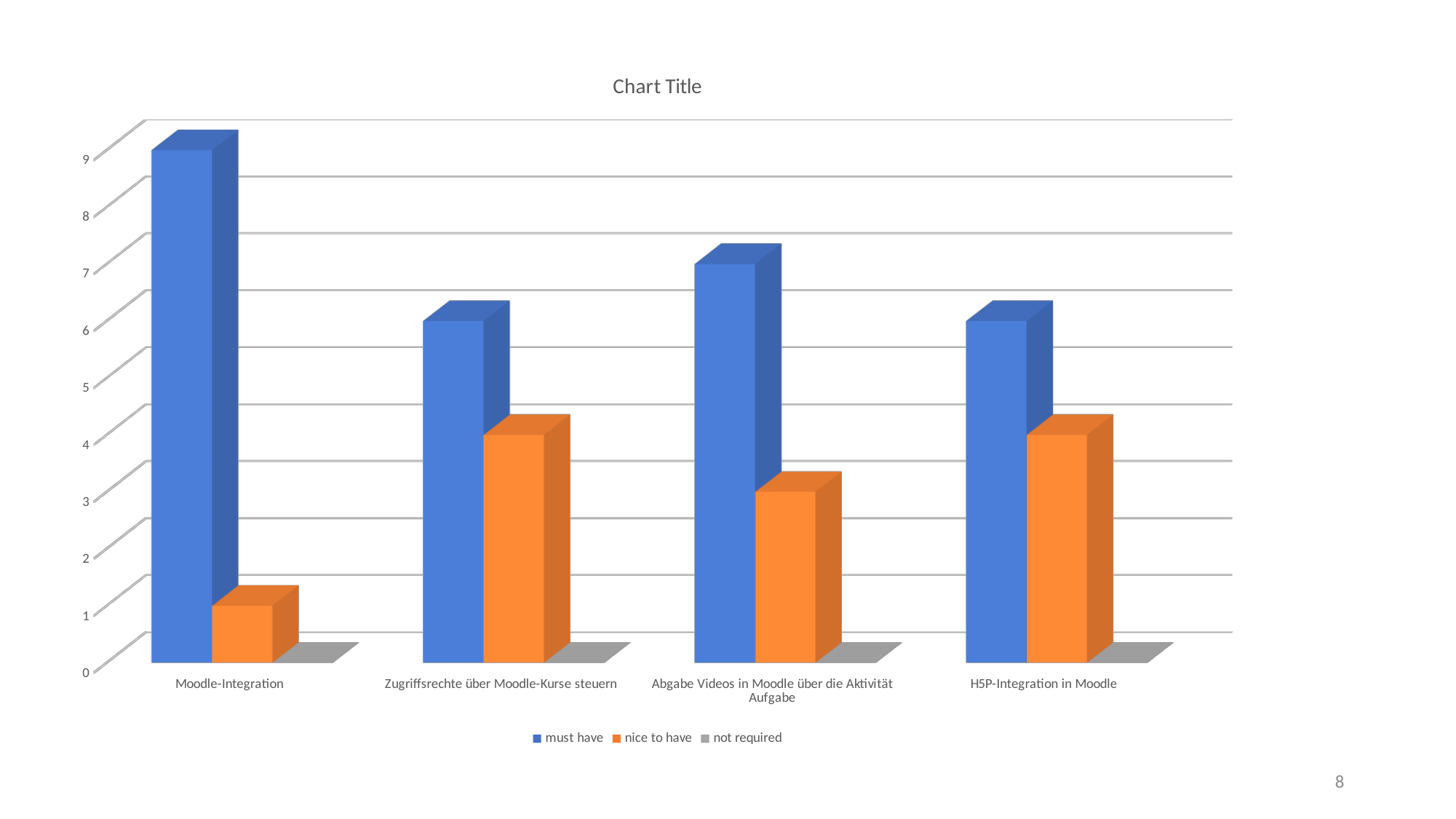
What kind of chart is shown on the slide? bar chart Is the 'nice to have' value for Abgabe Videos in Moodle über die Aktivität Aufgabe greater or less than 4? less How many series does the legend list? 3 Which category has the lowest 'nice to have' value? Moodle-Integration How many categories are shown on the x axis? 4 Is the 'must have' value for Abgabe Videos in Moodle über die Aktivität Aufgabe greater or less than 6? greater Which category has the highest 'must have' value? Moodle-Integration Is the 'must have' value for Moodle-Integration greater or less than 8? greater Which is larger for Zugriffsrechte über Moodle-Kurse steuern: the 'must have' value or the 'nice to have' value? must have Which category has the larger 'must have' value: Moodle-Integration or H5P-Integration in Moodle? Moodle-Integration What colour represents the 'nice to have' series in the legend? orange